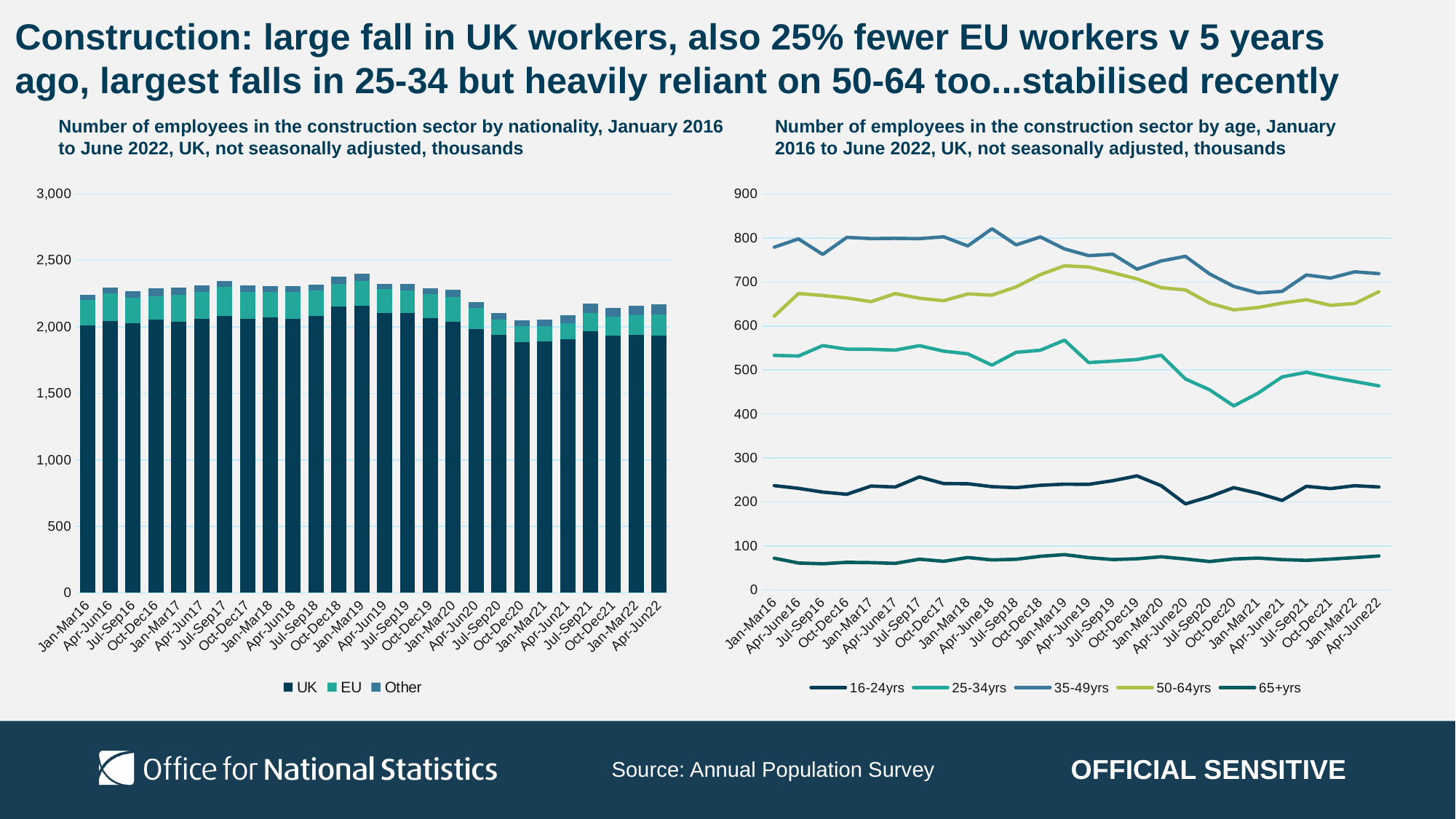
How many series does the legend of the left chart (by nationality) list? 3 On the right chart (by age), which age group has the highest values across the whole period? 35-49yrs On the right chart (by age), is the value for 35-49yrs in Apr-June18 greater or less than 800? greater What kind of chart is the right chart, 'Number of employees in the construction sector by age'? Line chart How many series does the legend of the right chart (by age) list? 5 On the left chart (by nationality), is the UK segment for Oct-Dec20 greater or less than 2,000? less What kind of chart is the left chart, 'Number of employees in the construction sector by nationality'? Stacked bar chart On the right chart (by age), does the 25-34yrs line rise or fall overall from Jan-Mar16 to Apr-June22? Fall How many bars (quarters) are plotted on the left chart (by nationality)? 26 On the right chart (by age), in Jan-Mar16 which is larger, the value for 35-49yrs or the value for 50-64yrs? 35-49yrs On the right chart (by age), which age group has the lowest values across the whole period? 65+yrs On the right chart (by age), is the value for 25-34yrs in Oct-Dec20 greater or less than 500? less